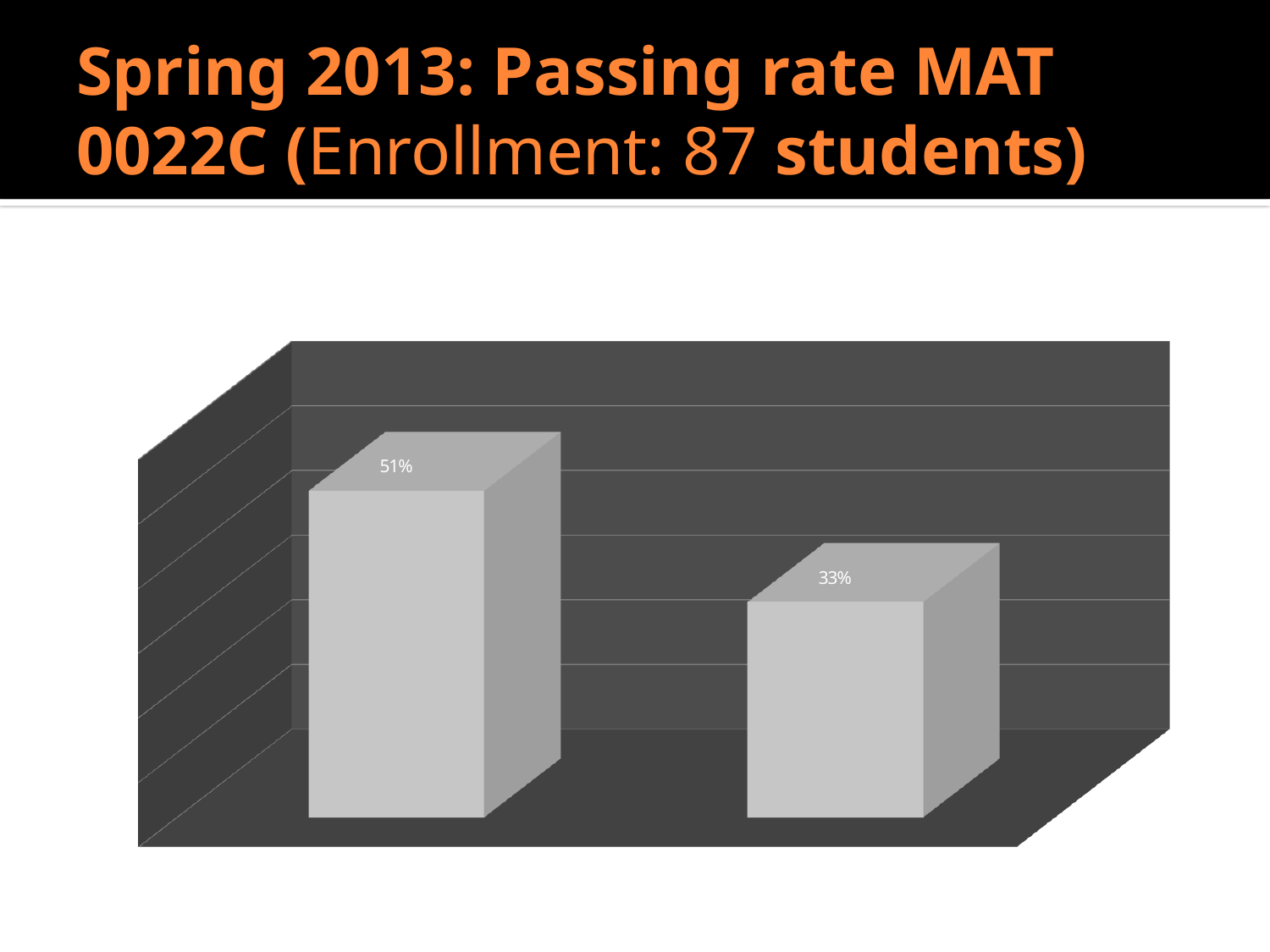
Which bar shows the highest value, the left or the right? the left bar What course does the slide title say the passing rate is for? MAT 0022C What kind of chart is shown on the slide? bar chart Do the values fall or rise from the left bar to the right bar? fall Which bar shows the lowest value, the left or the right? the right bar According to the slide title, how many students were enrolled in MAT 0022C in Spring 2013? 87 How many bars are plotted in the chart? 2 Which bar is taller, the left bar or the right bar? the left bar What is the difference between the left bar's value and the right bar's value? 18% What value is shown on the right bar of the chart? 33% What value is shown on the left bar of the chart? 51%